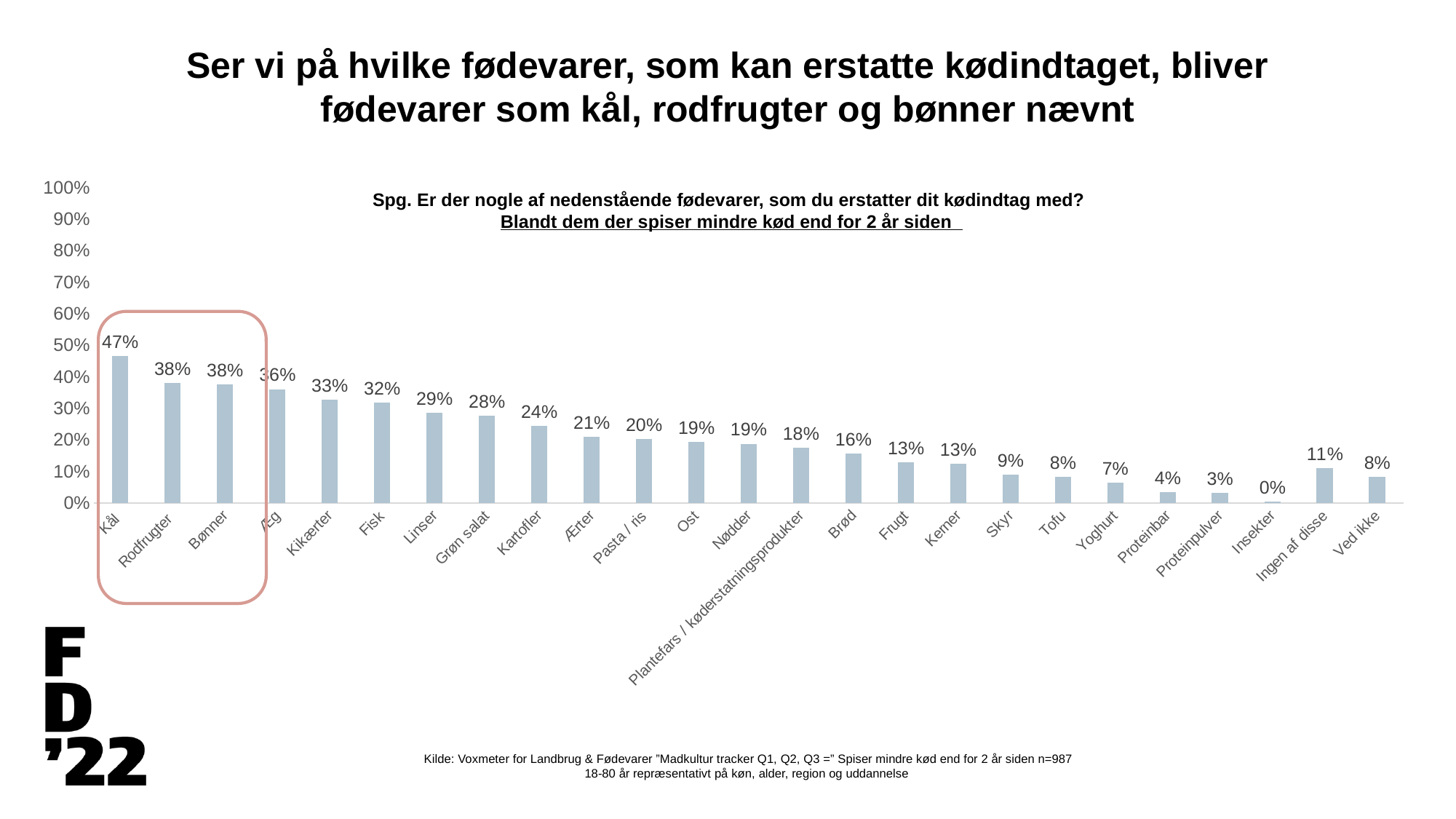
Do the values generally rise or fall along the x axis from Kål to Insekter? Fall What is the difference between the values for Kål and Rodfrugter? 9 percentage points What percentage is shown for Ingen af disse? 11% How many categories are shown on the x axis? 25 Which has a higher value, Fisk or Linser? Fisk What is the difference between the values for Kartofler and Ærter? 3 percentage points What percentage is shown for Kikærter? 33% What percentage is shown for Kål? 47% Which food category has the highest value? Kål What kind of chart is shown on the slide? Bar chart Which category has the lowest value? Insekter What percentage is shown for Tofu? 8%